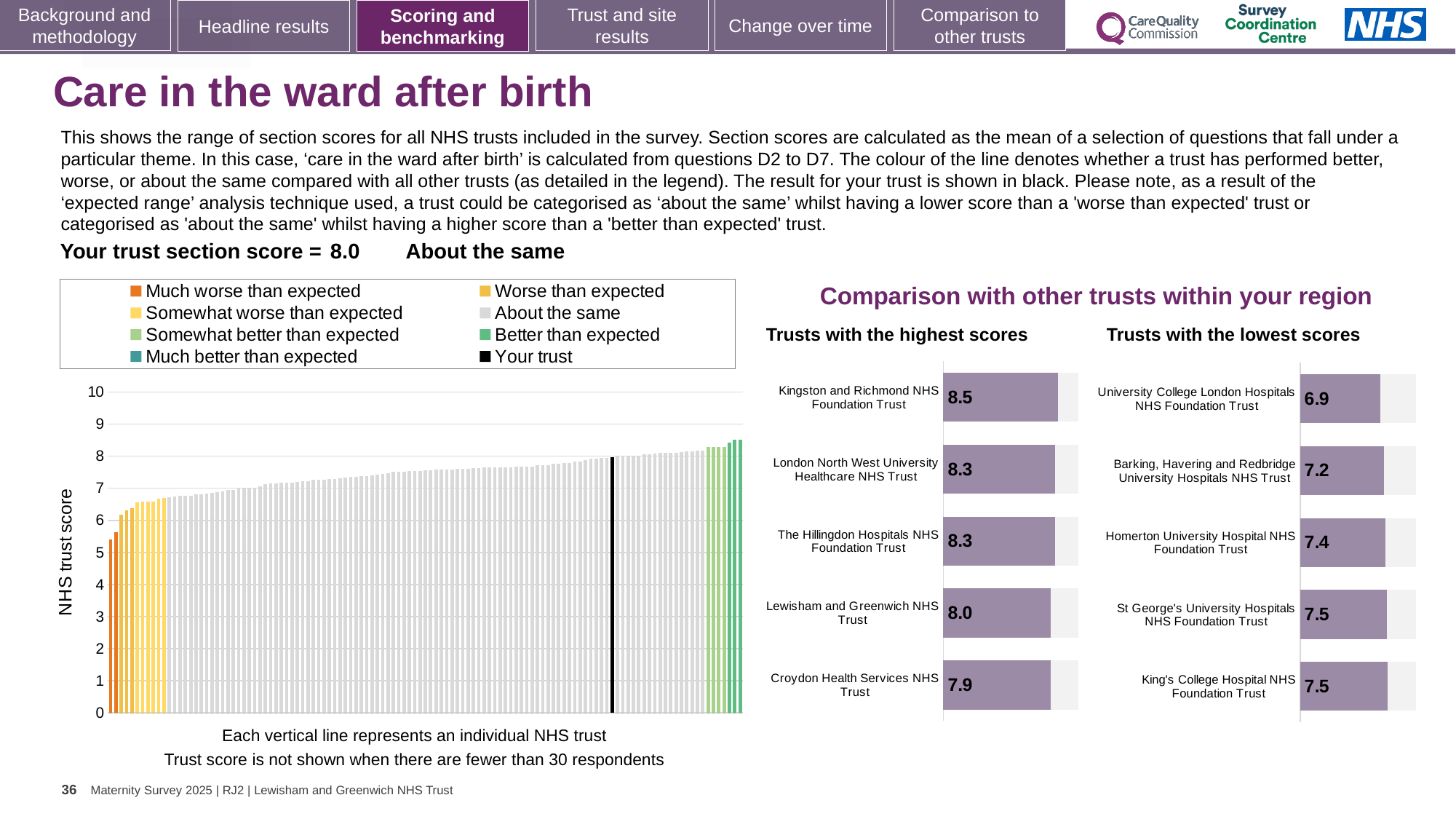
In the 'NHS trust score' chart on the left, do the values rise or fall from left to right? Rise In the 'Trusts with the highest scores' chart, which trust has the highest score? Kingston and Richmond NHS Foundation Trust How many entries does the legend of the 'NHS trust score' chart list? 8 In the 'Trusts with the highest scores' chart, what is the score for Kingston and Richmond NHS Foundation Trust? 8.5 What kind of chart is the 'NHS trust score' chart on the left of the slide? Bar chart In the 'Trusts with the lowest scores' chart, what is the score for King's College Hospital NHS Foundation Trust? 7.5 In the 'NHS trust score' chart on the left, what colour represents 'Your trust' in the legend? Black In the 'Trusts with the lowest scores' chart, which trust has the lowest score? University College London Hospitals NHS Foundation Trust In the 'Trusts with the lowest scores' chart, what is the score for University College London Hospitals NHS Foundation Trust? 6.9 How many trusts are shown in the 'Trusts with the highest scores' chart? 5 In the 'Trusts with the highest scores' chart, what is the difference between the scores of Kingston and Richmond NHS Foundation Trust and Croydon Health Services NHS Trust? 0.6 In the 'Trusts with the lowest scores' chart, which has the larger score: Barking, Havering and Redbridge University Hospitals NHS Trust or Homerton University Hospital NHS Foundation Trust? Homerton University Hospital NHS Foundation Trust